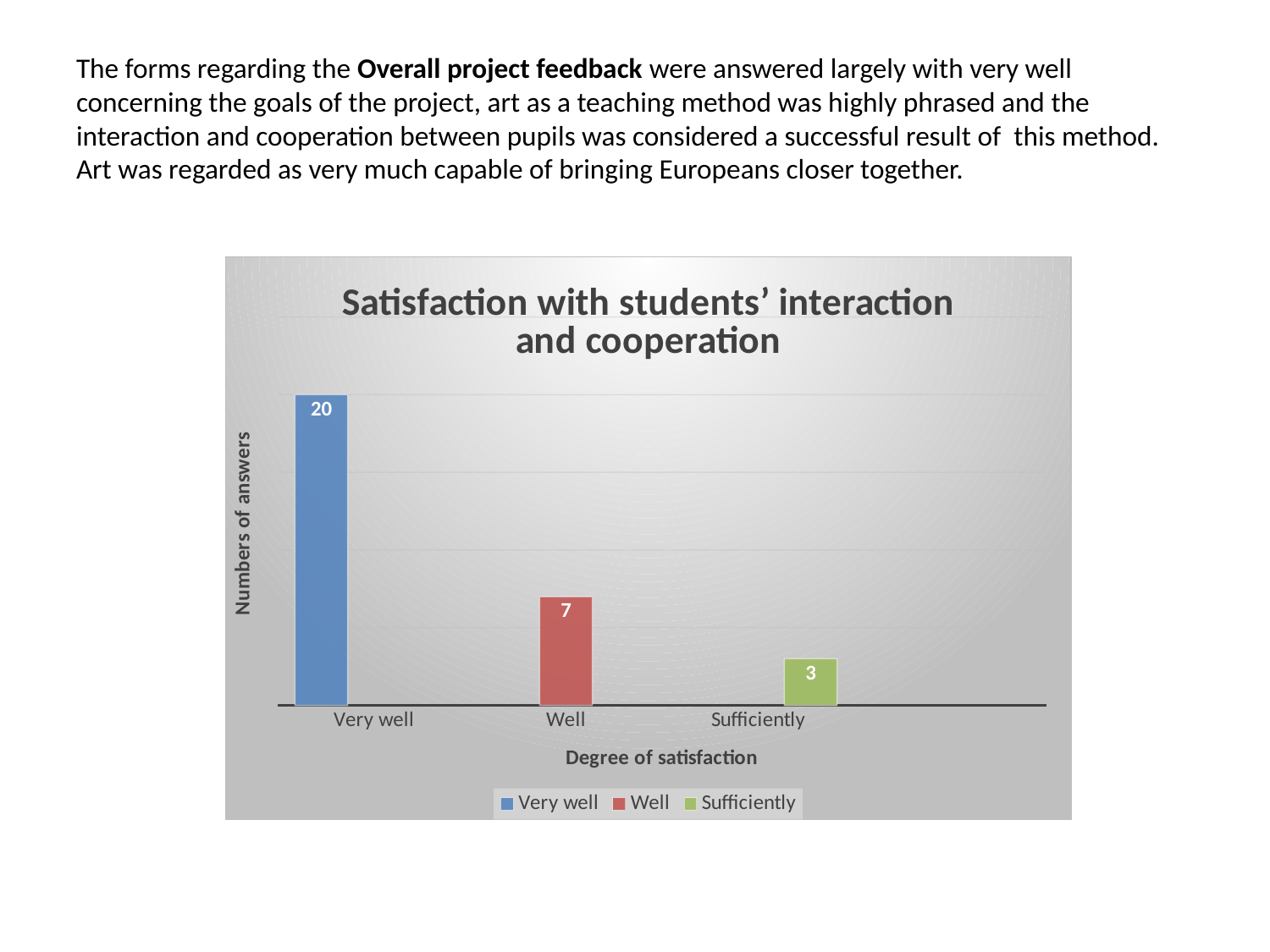
What is the title of the chart? Satisfaction with students' interaction and cooperation What kind of chart is shown? Bar chart What is the value for Very well? 20 Which is larger, the value for Well or the value for Sufficiently? Well What is the difference between the values for Very well and Well? 13 What is the value for Sufficiently? 3 What is the difference between the values for Well and Sufficiently? 4 What is the value for Well? 7 Which category has the lowest number of answers? Sufficiently How many categories are shown on the x axis? 3 How many entries does the legend list? 3 Which category has the highest number of answers? Very well